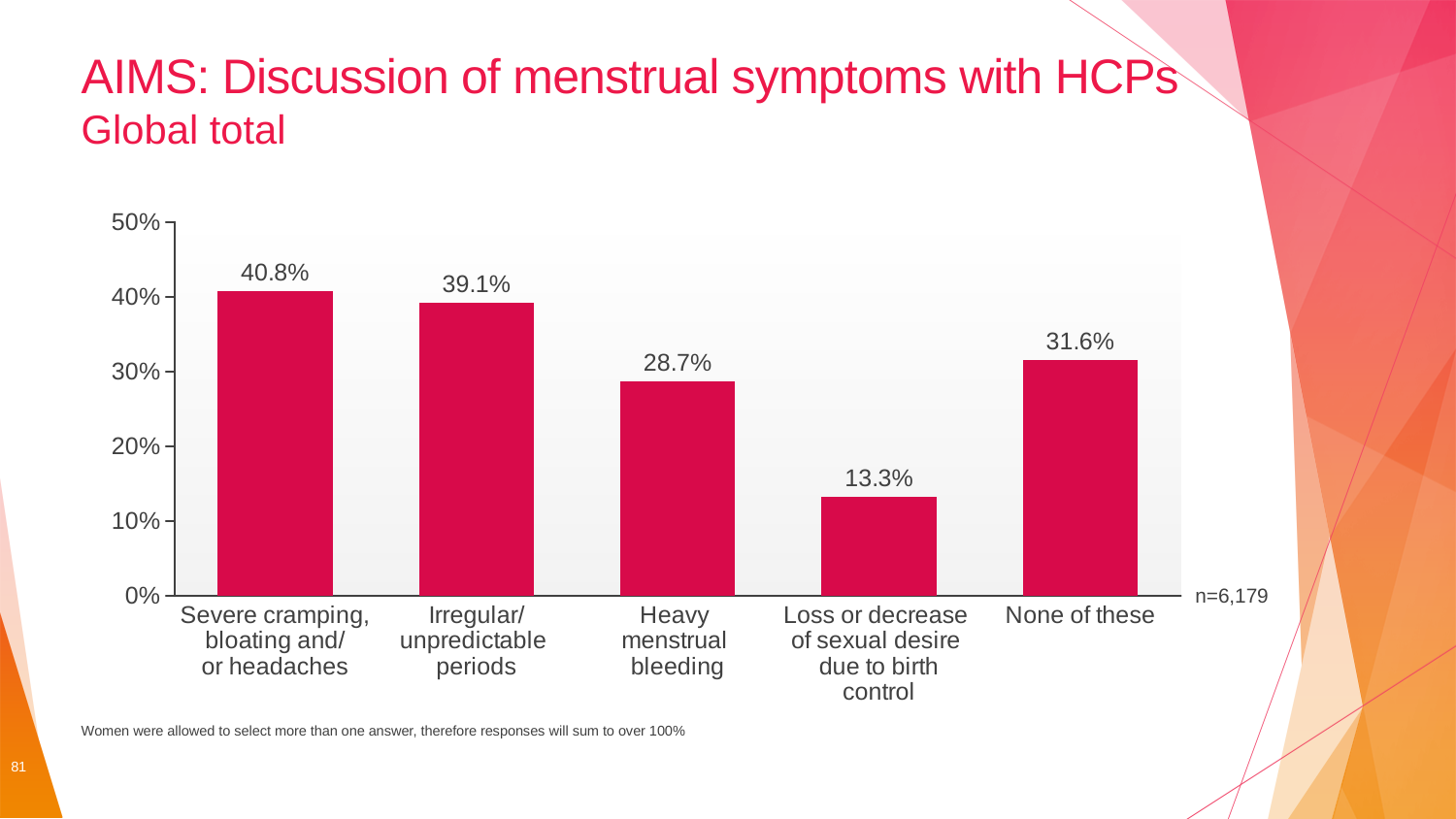
What type of chart is shown on the slide? Bar chart What percentage is shown for loss or decrease of sexual desire due to birth control? 13.3% Which category has the lowest value? Loss or decrease of sexual desire due to birth control What percentage of women discussed severe cramping, bloating and/or headaches with HCPs? 40.8% Which category has the highest value? Severe cramping, bloating and/or headaches What is the value shown for heavy menstrual bleeding? 28.7% How many categories are shown on the chart? 5 What is the sample size (n) shown next to the chart? n=6,179 Which is larger: the value for 'None of these' or the value for heavy menstrual bleeding? None of these What is the value for 'None of these'? 31.6% What is the difference between the values for irregular/unpredictable periods and heavy menstrual bleeding? 10.4% Is the value for irregular/unpredictable periods greater or less than 30%? greater